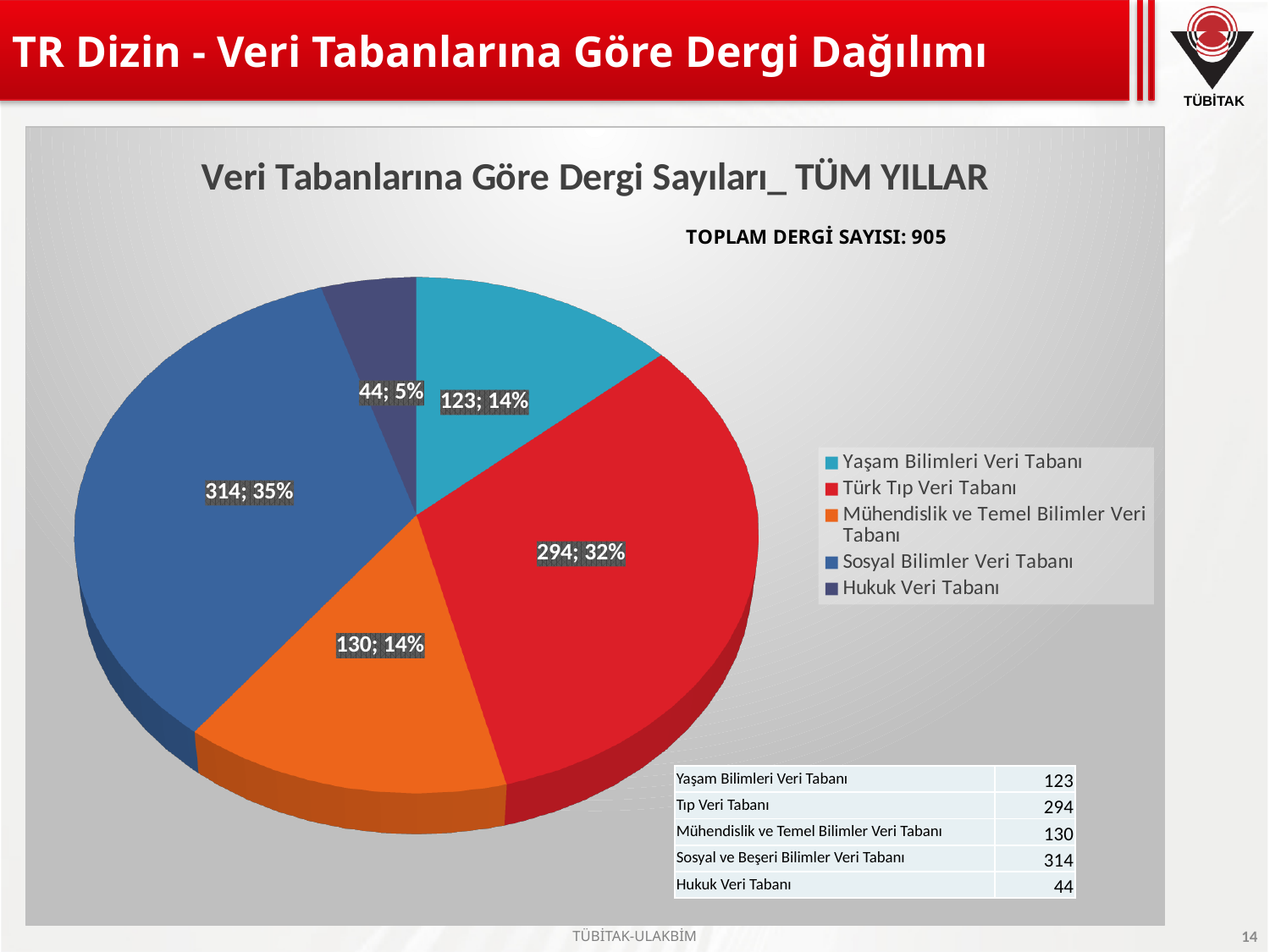
What share of the pie does Mühendislik ve Temel Bilimler Veri Tabanı represent? 14% Which category has the largest slice? Sosyal Bilimler Veri Tabanı How many entries does the legend list? 5 What is the value for Türk Tıp Veri Tabanı? 294 What is the value for Sosyal Bilimler Veri Tabanı? 314 How many slices does the pie chart have? 5 What is the title of the chart? Veri Tabanlarına Göre Dergi Sayıları_ TÜM YILLAR Which category has the smallest slice? Hukuk Veri Tabanı What is the value for Hukuk Veri Tabanı? 44 What kind of chart is shown on the slide? pie chart What share of the pie does Sosyal Bilimler Veri Tabanı represent? 35% What is the difference between the values for Sosyal Bilimler Veri Tabanı and Türk Tıp Veri Tabanı? 20